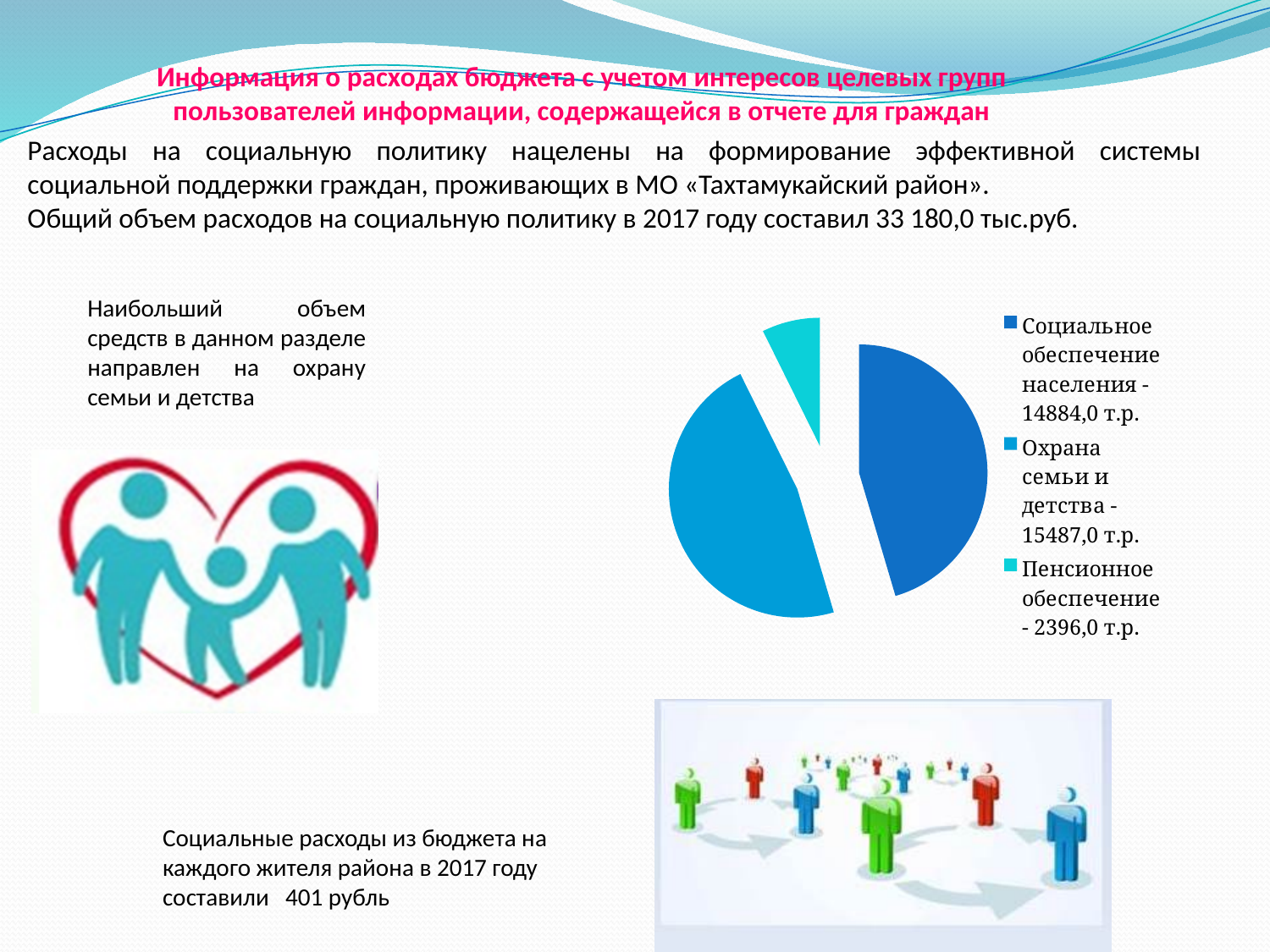
What value is given for Социальное обеспечение населения in the pie chart legend? 14884,0 т.р. What value is given for Охрана семьи и детства in the pie chart legend? 15487,0 т.р. What is the difference between the values for Охрана семьи и детства and Социальное обеспечение населения? 603,0 т.р. How many entries does the legend of the pie chart list? 3 What is the difference between the values for Социальное обеспечение населения and Пенсионное обеспечение? 12488,0 т.р. Which category has the smallest value in the pie chart? Пенсионное обеспечение What kind of chart is shown on the slide? pie chart Which category has the largest value in the pie chart? Охрана семьи и детства How many slices does the pie chart have? 3 Which is larger: Социальное обеспечение населения or Пенсионное обеспечение? Социальное обеспечение населения What value is given for Пенсионное обеспечение in the pie chart legend? 2396,0 т.р. What colour is the slice for Пенсионное обеспечение in the pie chart? light blue (cyan)